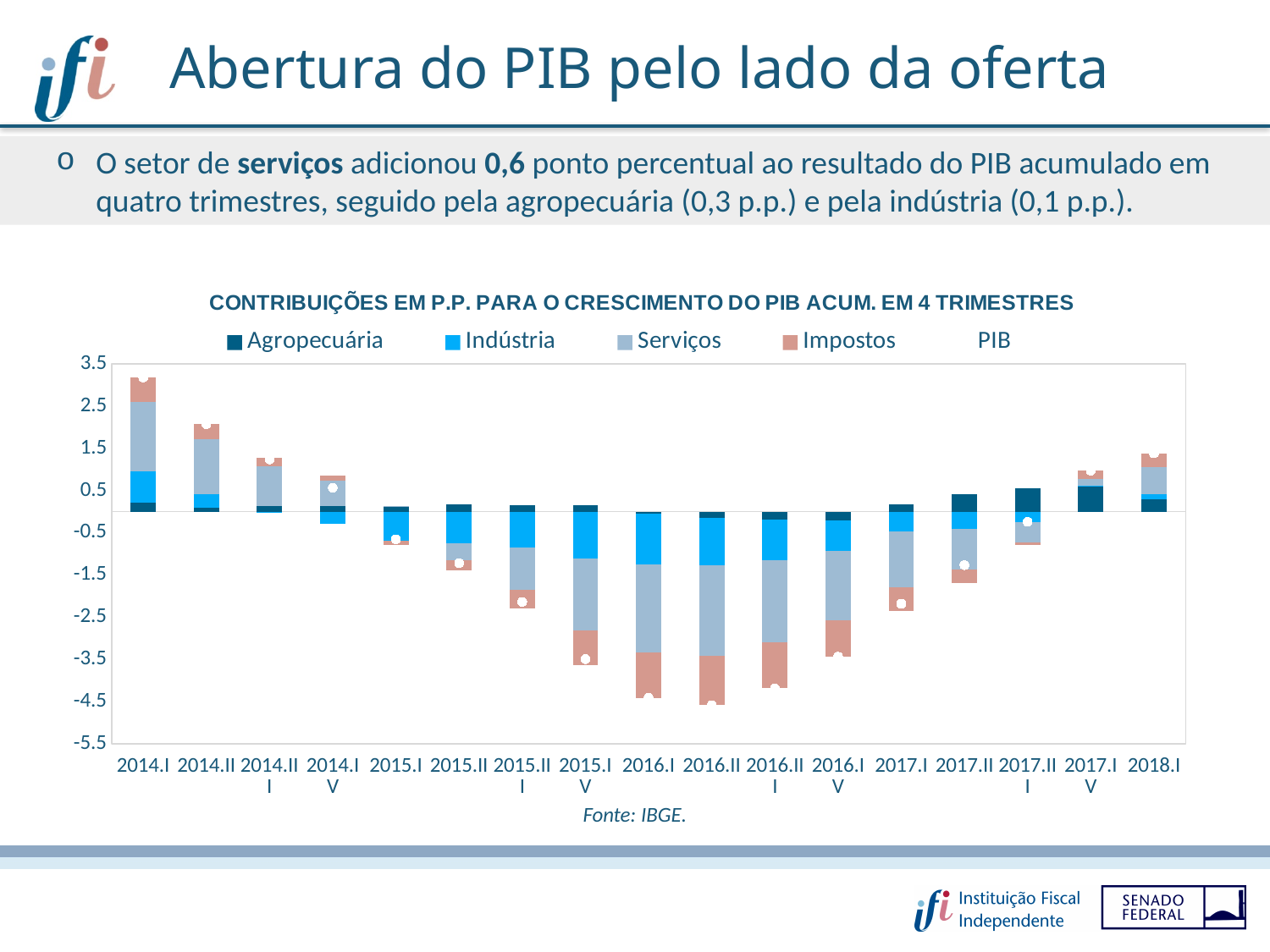
What source is cited below the chart? IBGE How many quarters (categories) are shown on the x axis of the chart? 17 Which quarter has the tallest positive stacked bar in the chart? 2014.I Do the stacked bars rise or fall from 2016.II to 2018.I? rise Which is larger, the positive stacked bar for 2014.I or the positive stacked bar for 2018.I? 2014.I Is the bottom of the stacked bar for 2015.I greater or less than -1.5? greater Is the top of the stacked bar for 2014.I greater or less than 2.5? greater What is the title of the chart? CONTRIBUIÇÕES EM P.P. PARA O CRESCIMENTO DO PIB ACUM. EM 4 TRIMESTRES Do the stacked bars rise or fall from 2014.I to 2016.II? fall Is the bottom of the Impostos segment for 2016.II greater or less than -3.5? less What kind of chart is shown on the slide? bar chart How many series does the chart legend list? 5